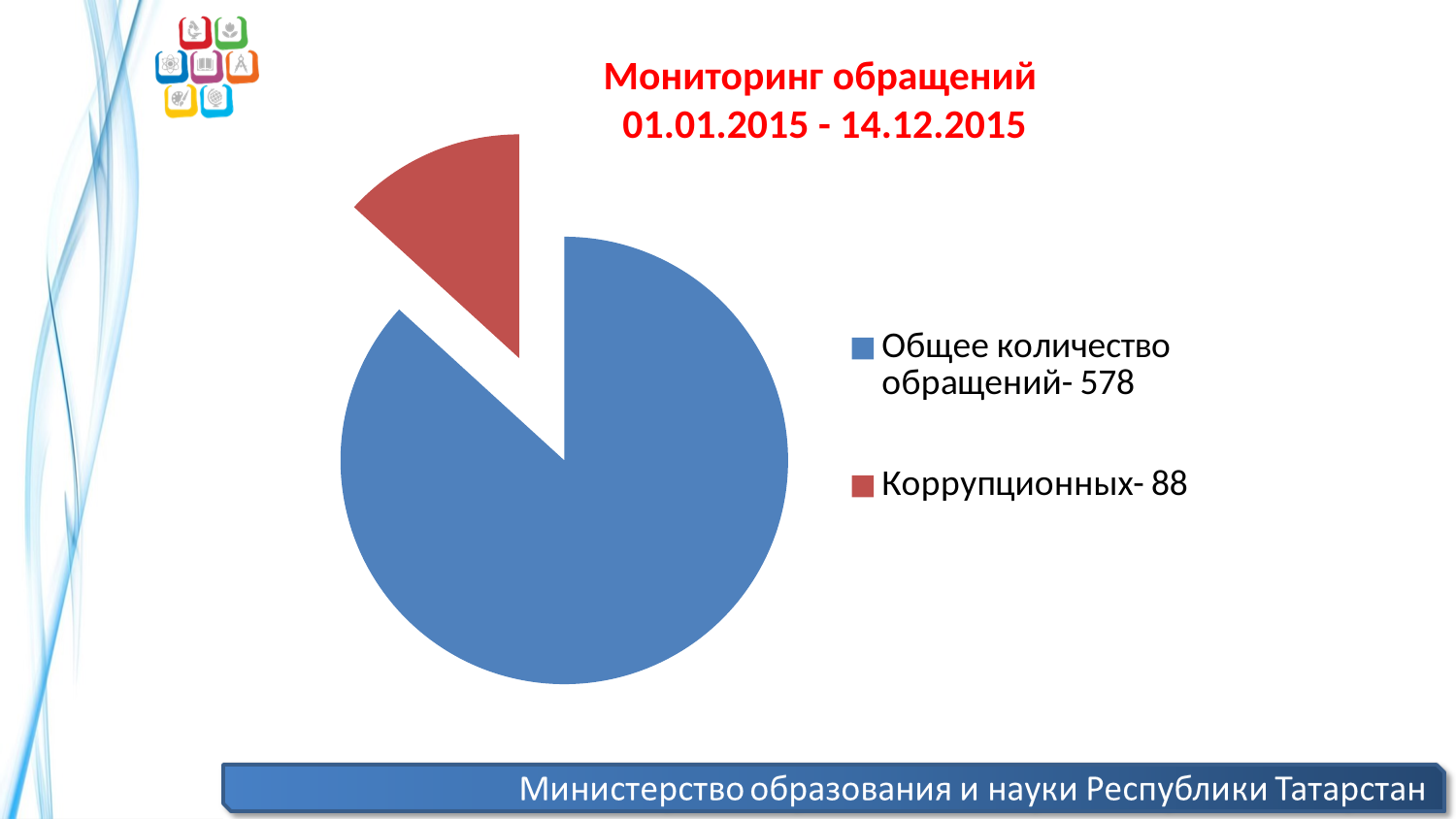
Which slice is the smallest? Коррупционных- 88 Which slice is the largest? Общее количество обращений- 578 What kind of chart is shown on the slide? pie chart What is the difference between the value for "Общее количество обращений" and the value for "Коррупционных"? 490 How many slices does the pie chart have? 2 Which is larger, the value for "Общее количество обращений" or for "Коррупционных"? Общее количество обращений Is the value for "Коррупционных" greater or less than 100? less How many entries does the legend list? 2 What value is given for "Общее количество обращений" in the legend? 578 What value is given for "Коррупционных" in the legend? 88 What is the title of the chart? Мониторинг обращений 01.01.2015 - 14.12.2015 What colour is the slice for "Коррупционных"? red